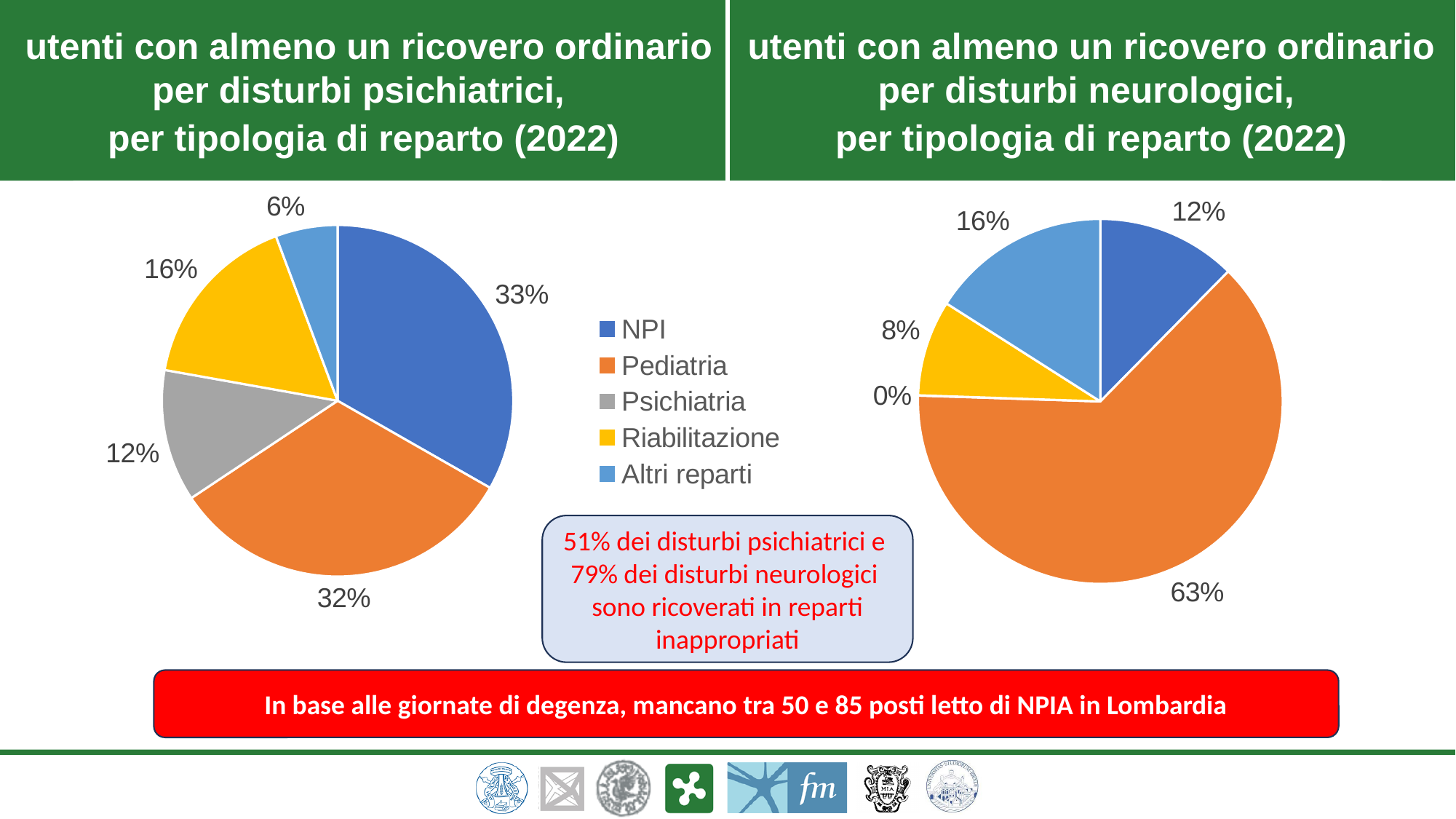
Which colour represents Riabilitazione in the legend? Yellow In the right pie chart (disturbi neurologici), what share is labelled for Psichiatria? 0% In the left pie chart (disturbi psichiatrici), what share is labelled for the NPI slice? 33% What type of chart is used on the left side of the slide? Pie chart In the right pie chart (disturbi neurologici), what is the difference between the Pediatria share and the NPI share? 51% In the right pie chart (disturbi neurologici), which category has the largest slice? Pediatria In the left pie chart (disturbi psichiatrici), which category has the smallest slice? Altri reparti How many entries does the legend list? 5 In the left pie chart (disturbi psichiatrici), what share is labelled for Pediatria? 32% In the left pie chart (disturbi psichiatrici), what share is labelled for Altri reparti? 6% In the right pie chart (disturbi neurologici), what share is labelled for Pediatria? 63% In the left pie chart (disturbi psichiatrici), which is larger: the Riabilitazione slice or the Psichiatria slice? Riabilitazione